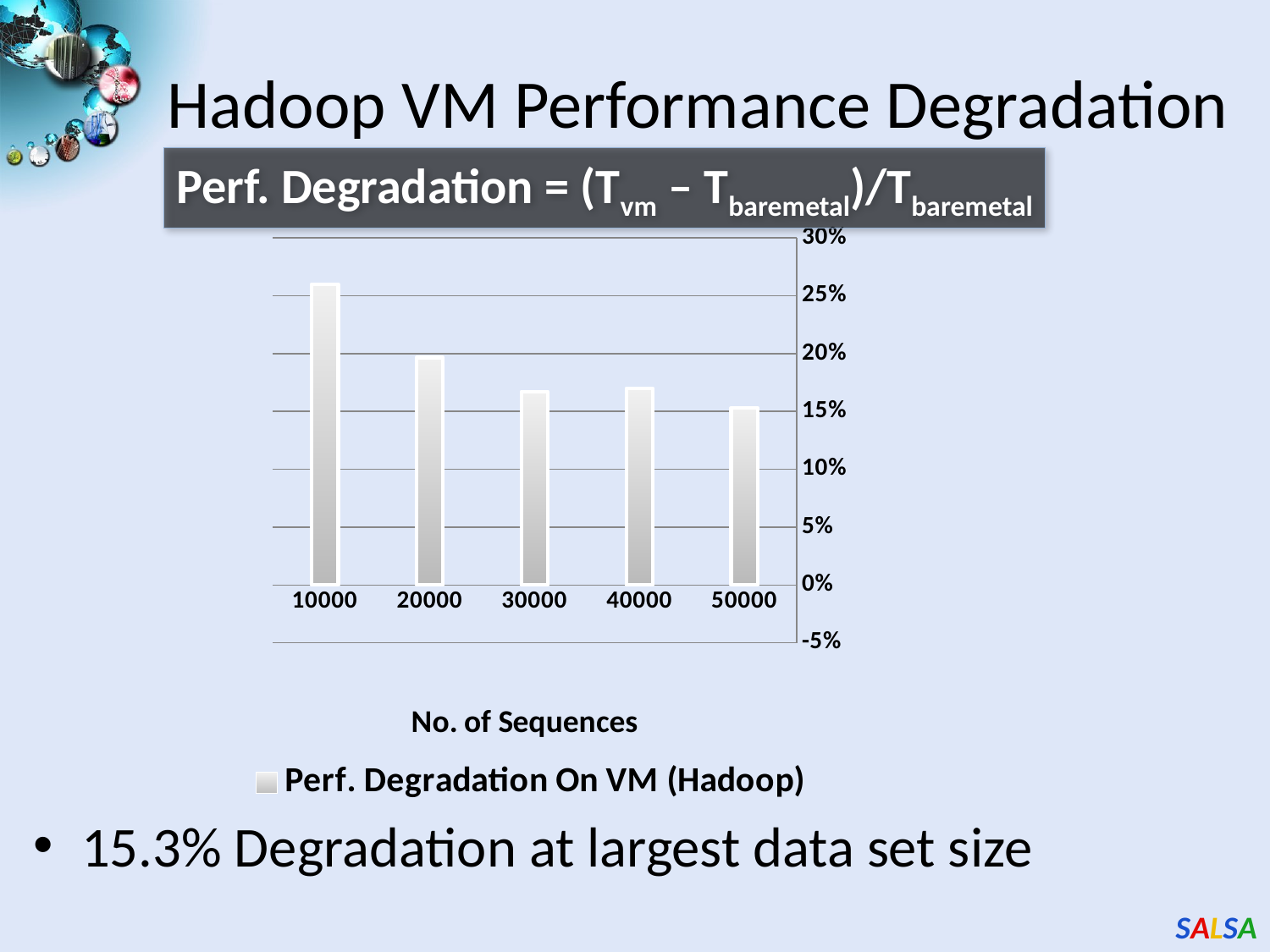
How many categories are plotted along the x axis? 5 Which has a larger performance degradation, 10000 or 20000 sequences? 10000 What is the title of the x axis? No. of Sequences How many series does the legend list? 1 Which number of sequences has the lowest performance degradation? 50000 Is the performance degradation for 10000 sequences greater or less than 25%? greater What series name is shown in the legend? Perf. Degradation On VM (Hadoop) Is the performance degradation for 30000 sequences greater or less than 20%? less What kind of chart is shown on the slide? bar chart Do the performance degradation values generally rise or fall as the number of sequences increases? fall Which number of sequences has the highest performance degradation? 10000